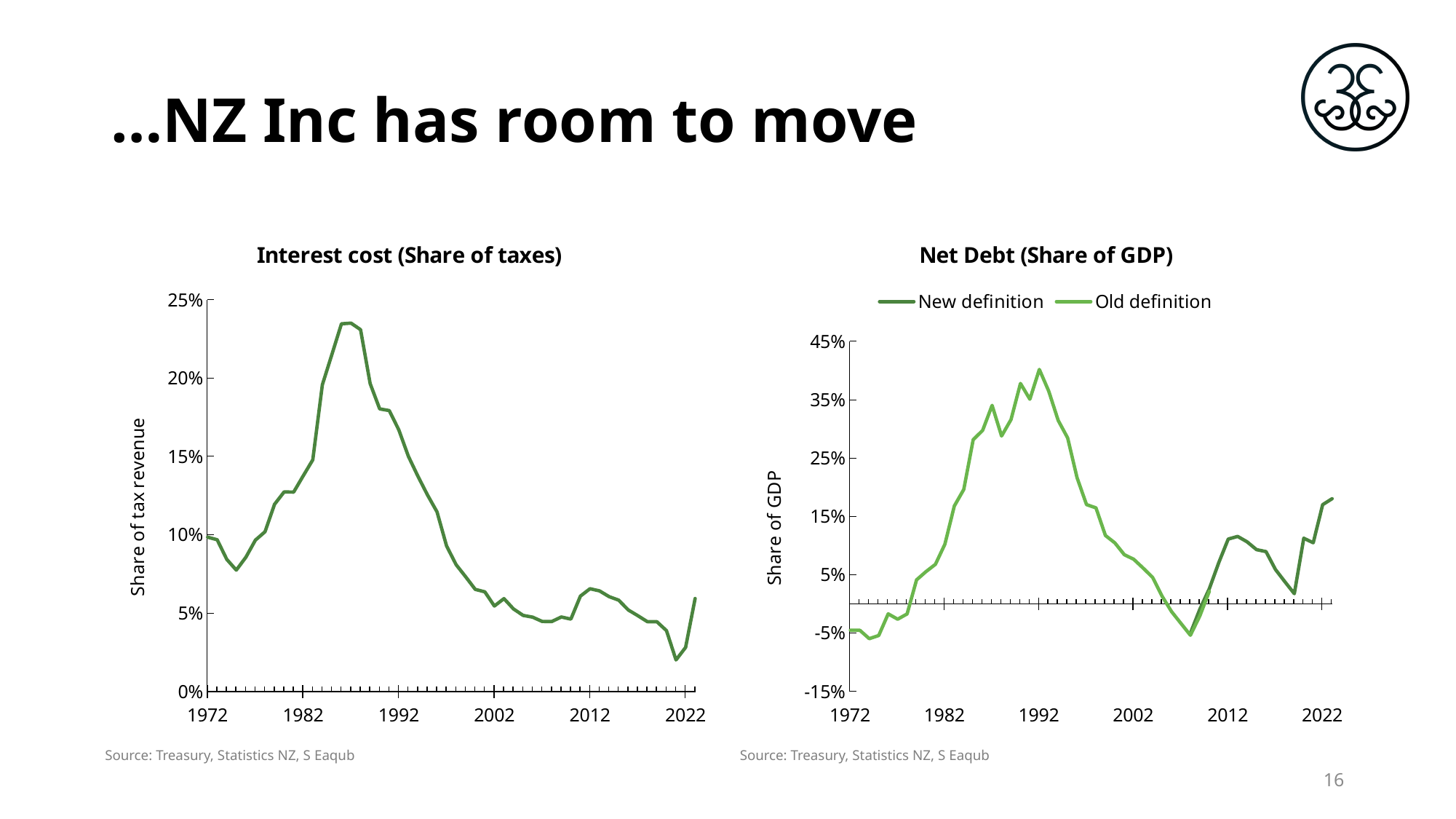
In the 'Net Debt (Share of GDP)' chart, is the value in 2022 greater or less than 15%? greater In the 'Net Debt (Share of GDP)' chart, is the value in 1972 greater or less than 0%? less In the 'Net Debt (Share of GDP)' chart, which is larger: the value in 1992 or the value in 2012? 1992 In the 'Interest cost (Share of taxes)' chart, is the value in 2012 greater or less than 10%? less What kind of chart is the 'Interest cost (Share of taxes)' chart? line chart In the 'Net Debt (Share of GDP)' chart, do values rise or fall between 1982 and 1992? rise In the 'Interest cost (Share of taxes)' chart, do values rise or fall between 1992 and 2002? fall What is the y-axis label of the 'Interest cost (Share of taxes)' chart? Share of tax revenue In the 'Net Debt (Share of GDP)' chart, what are the two series named in the legend? New definition and Old definition How many series does the legend of the 'Net Debt (Share of GDP)' chart list? 2 In the 'Interest cost (Share of taxes)' chart, which is larger: the value in 1987 or the value in 2022? 1987